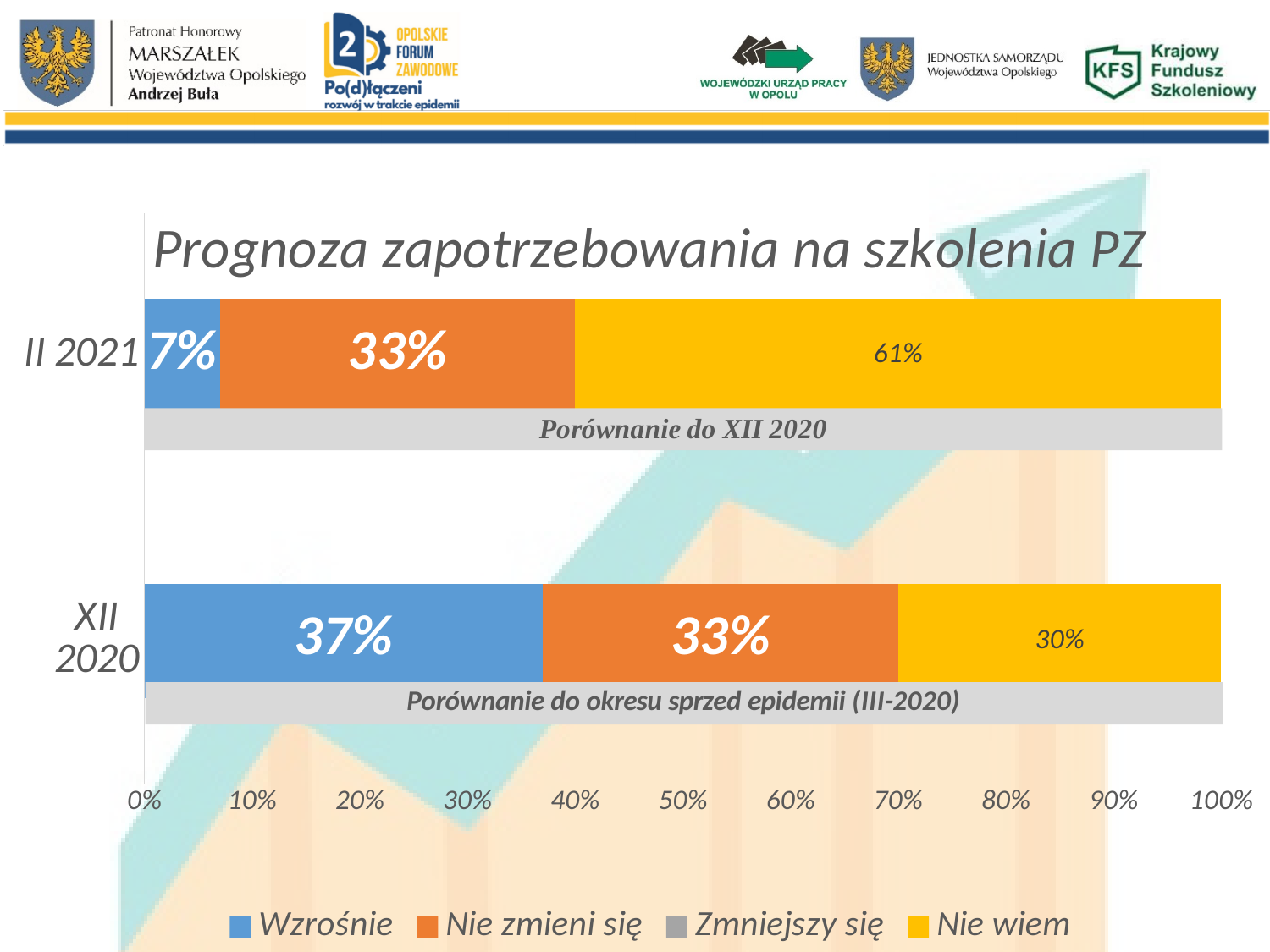
What is the value of 'Nie zmieni się' for XII 2020? 33% What is the title of the chart? Prognoza zapotrzebowania na szkolenia PZ What is the value of 'Nie wiem' for XII 2020? 30% What is the difference between 'Nie wiem' for II 2021 and 'Nie wiem' for XII 2020? 31% Which series has the largest share in the II 2021 bar? Nie wiem What type of chart is shown on the slide? stacked bar chart What is the value of 'Nie wiem' for II 2021? 61% What is the value of 'Wzrośnie' for II 2021? 7% What is the value of 'Wzrośnie' for XII 2020? 37% Which is larger: 'Wzrośnie' for XII 2020 or 'Wzrośnie' for II 2021? XII 2020 How many series does the legend list? 4 Which colour represents 'Nie zmieni się' in the legend? orange